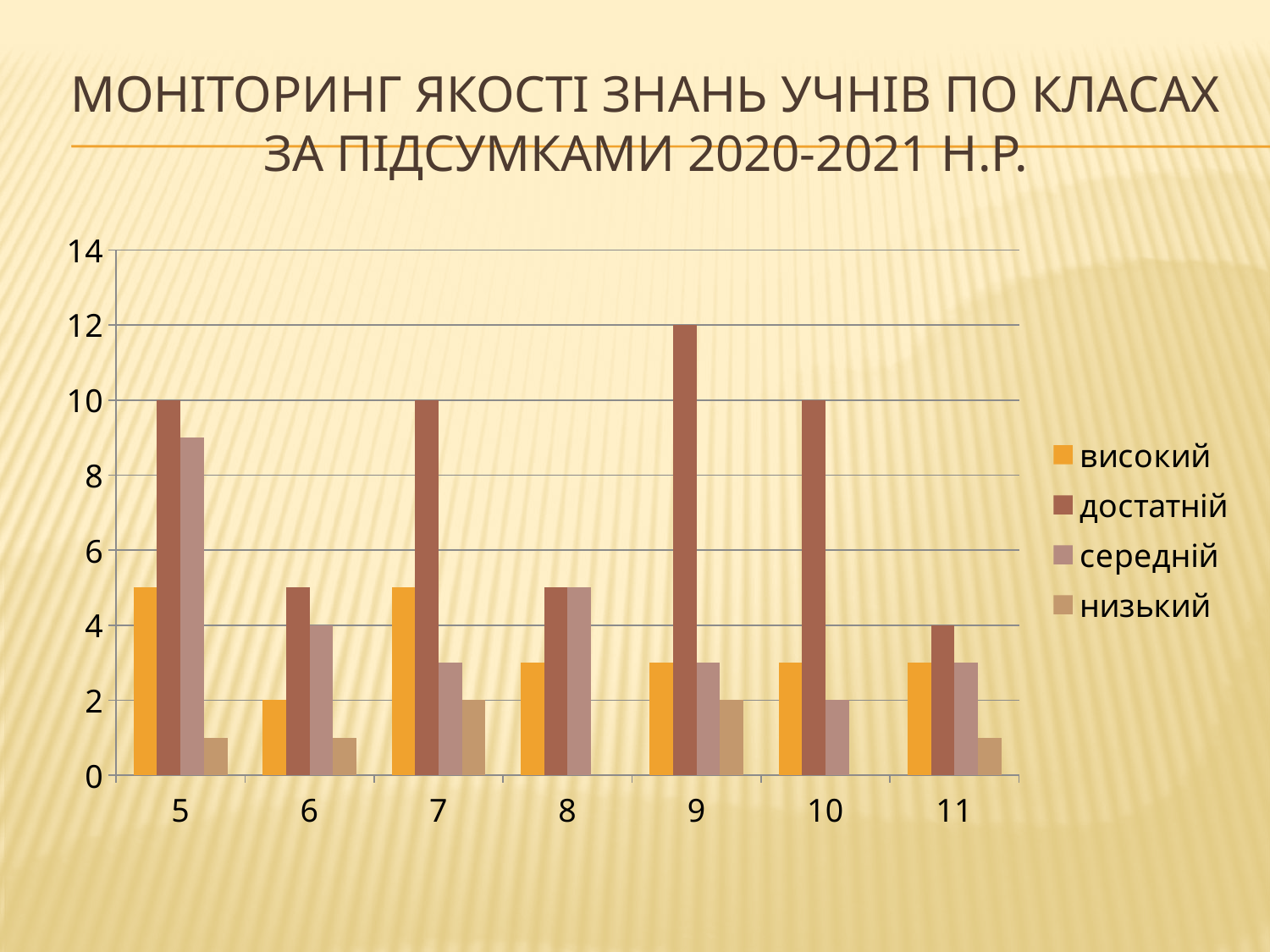
For which class is the достатній value highest? 9 What is the value of достатній for class 9? 12 What type of chart is shown on the slide? bar chart How many classes (categories) are shown on the x axis? 7 How many series does the legend list? 4 What is the value of середній for class 6? 4 Which series is shown in orange in the legend? високий What is the value of достатній for class 5? 10 What is the value of достатній for class 11? 4 Is the value of середній for class 5 greater or less than 8? greater Which is larger: середній for class 5 or середній for class 6? середній for class 5 Is the value of високий for class 8 greater or less than 4? less